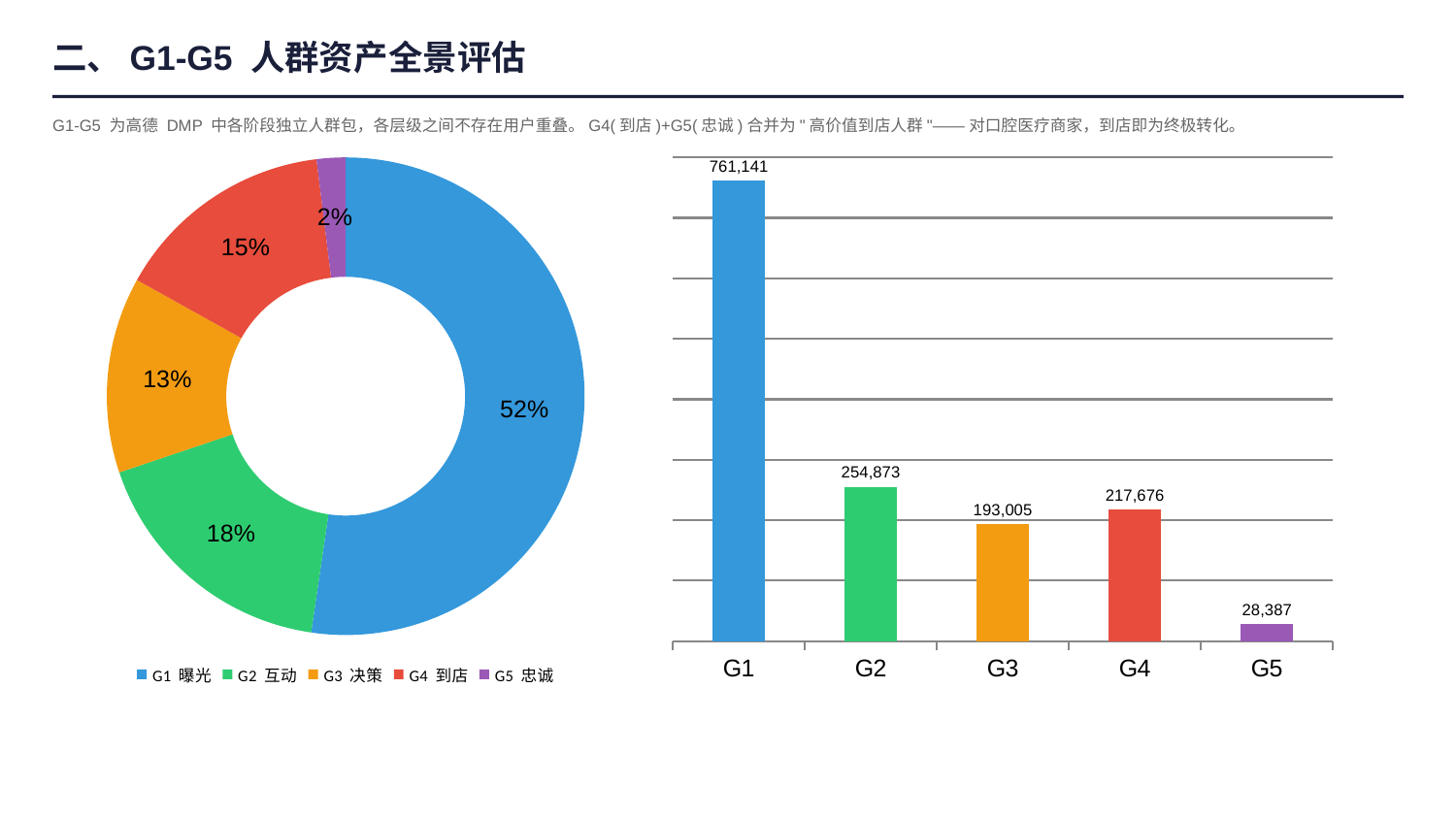
In the bar chart on the right, which category has the highest value? G1 How many categories are shown in the bar chart on the right? 5 In the pie chart on the left, what share does G4 到店 have? 15% In the bar chart on the right, what is the value for G1? 761,141 In the pie chart on the left, what share does G2 互动 have? 18% In the bar chart on the right, what is the value for G4? 217,676 In the bar chart on the right, what is the value for G5? 28,387 How many entries does the legend of the pie chart on the left list? 5 In the bar chart on the right, what is the difference between the values for G2 and G3? 61,868 In the bar chart on the right, which is larger, the value for G3 or the value for G4? G4 In the bar chart on the right, which category has the lowest value? G5 What kind of chart is on the left of the slide? Pie (donut) chart